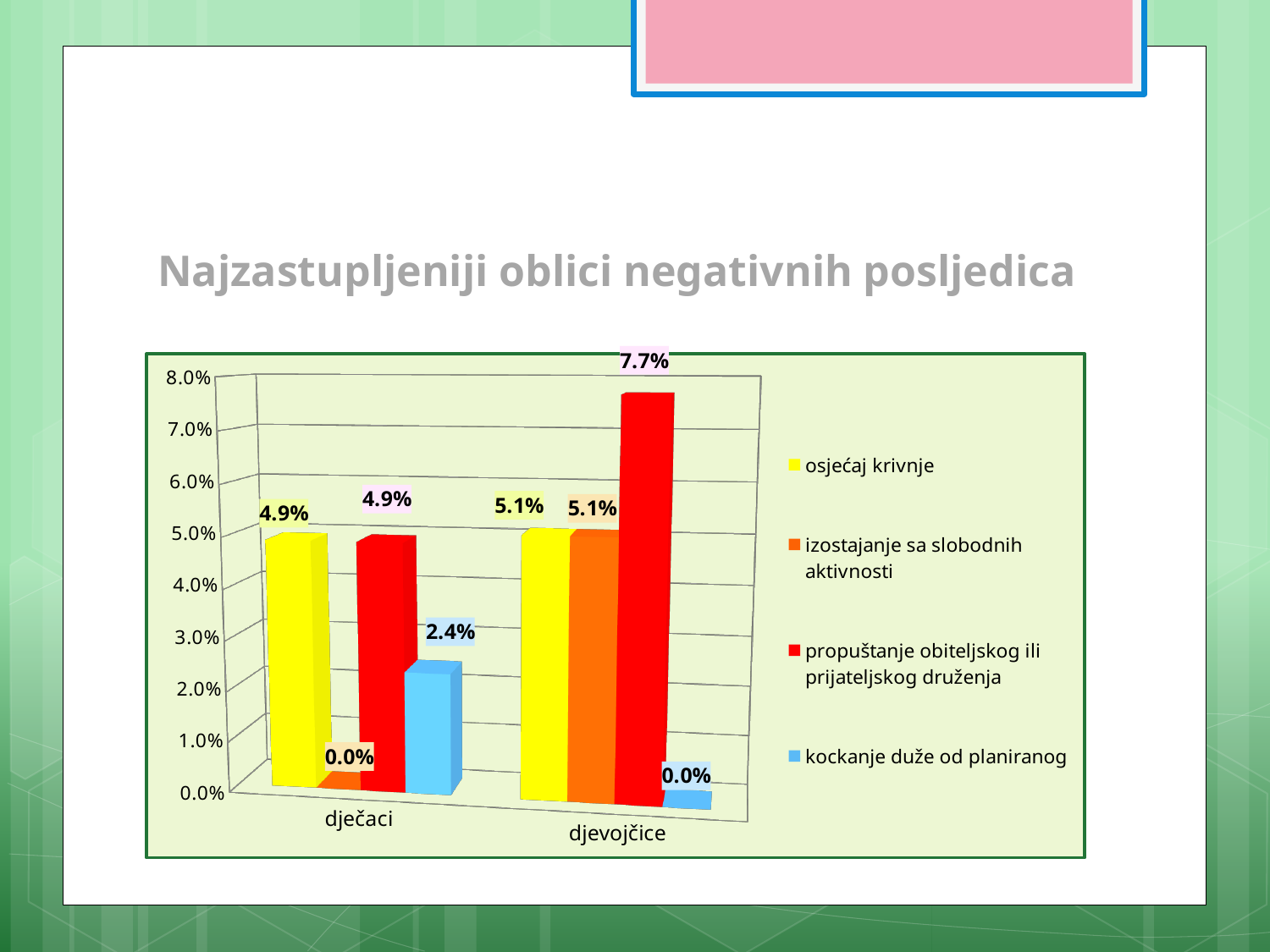
What is the value for 'osjećaj krivnje' for djevojčice? 5.1% What is the difference between the 'propuštanje obiteljskog ili prijateljskog druženja' values for djevojčice and dječaci? 2.8% Which series has the lowest value for dječaci? izostajanje sa slobodnih aktivnosti Which series has the highest value for djevojčice? propuštanje obiteljskog ili prijateljskog druženja What is the value for 'propuštanje obiteljskog ili prijateljskog druženja' for djevojčice? 7.7% What is the value for 'kockanje duže od planiranog' for dječaci? 2.4% How many categories are shown on the x axis? 2 What type of chart is shown on the slide? bar chart What is the value for 'izostajanje sa slobodnih aktivnosti' for dječaci? 0.0% How many series does the legend list? 4 What is the title of the chart? Najzastupljeniji oblici negativnih posljedica Which is larger: 'kockanje duže od planiranog' for dječaci or for djevojčice? dječaci